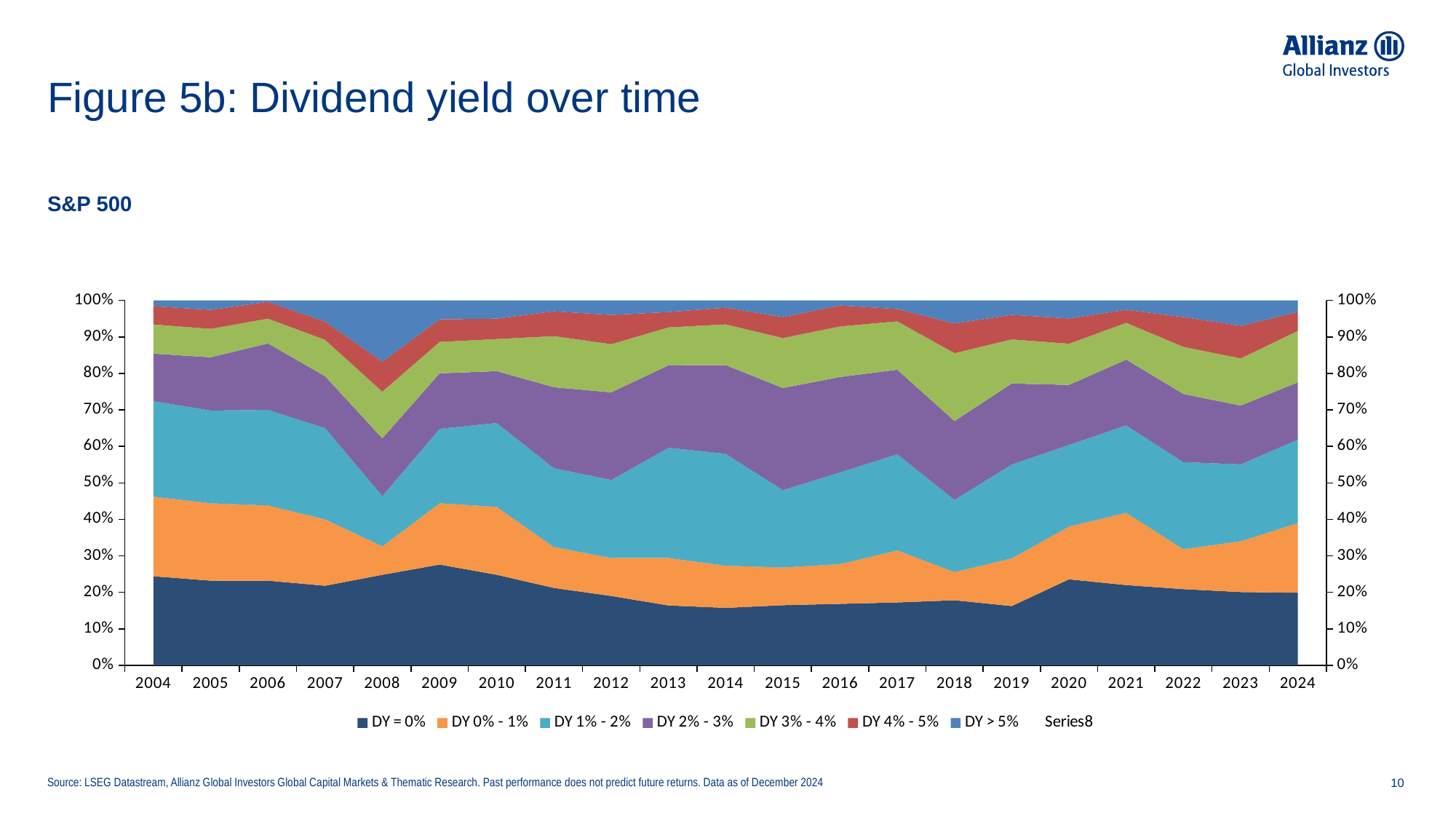
What kind of chart is shown on the slide? Stacked area chart How many years are plotted along the x axis? 21 Is the value for DY = 0% in 2009 greater or less than 20%? greater Does the DY = 0% share rise or fall from 2009 to 2014? fall Which is larger, the DY = 0% share in 2009 or in 2019? 2009 What is the last year shown on the x axis? 2024 What index does the chart cover, according to the subtitle? S&P 500 Is the value for DY = 0% in 2014 greater or less than 20%? less In which year is the DY = 0% share highest? 2009 Is the value for DY = 0% in 2019 greater or less than 20%? less How many series does the legend list? 8 What is the first year shown on the x axis? 2004